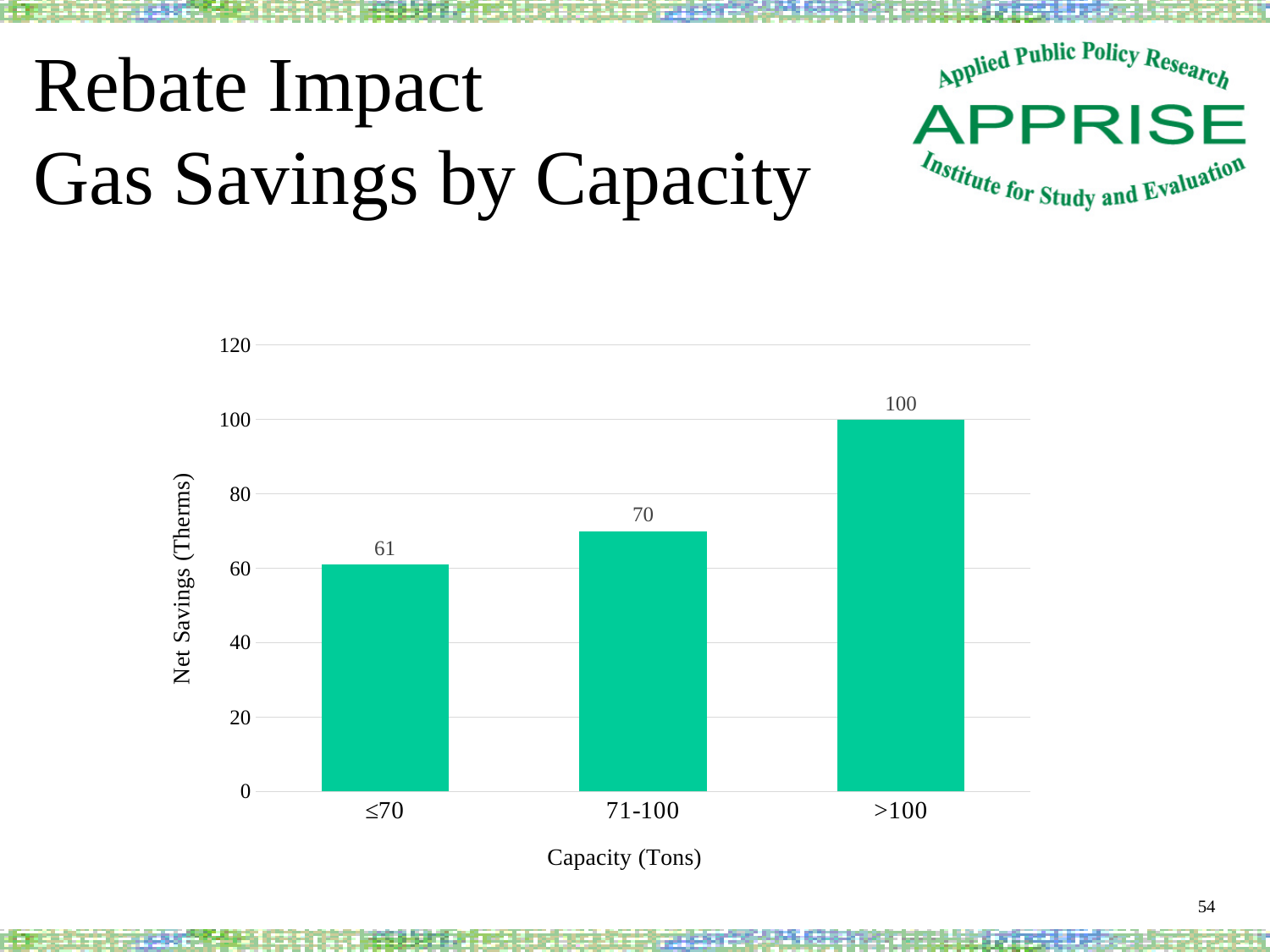
How many capacity categories are shown in the chart? 3 Which has larger net savings, the 71-100 category or the >100 category? >100 What is the net savings in therms for the 71-100 ton capacity category? 70 What kind of chart is shown on the slide? bar chart What is the net savings in therms for the ≤70 ton capacity category? 61 What is the difference in net savings between the 71-100 and ≤70 capacity categories? 9 Is the net savings for the 71-100 category greater or less than 80? less Which capacity category has the highest net savings? >100 What is the difference in net savings between the >100 and ≤70 capacity categories? 39 Which capacity category has the lowest net savings? ≤70 What is the net savings in therms for the >100 ton capacity category? 100 Do net savings rise or fall as capacity increases along the x axis? rise